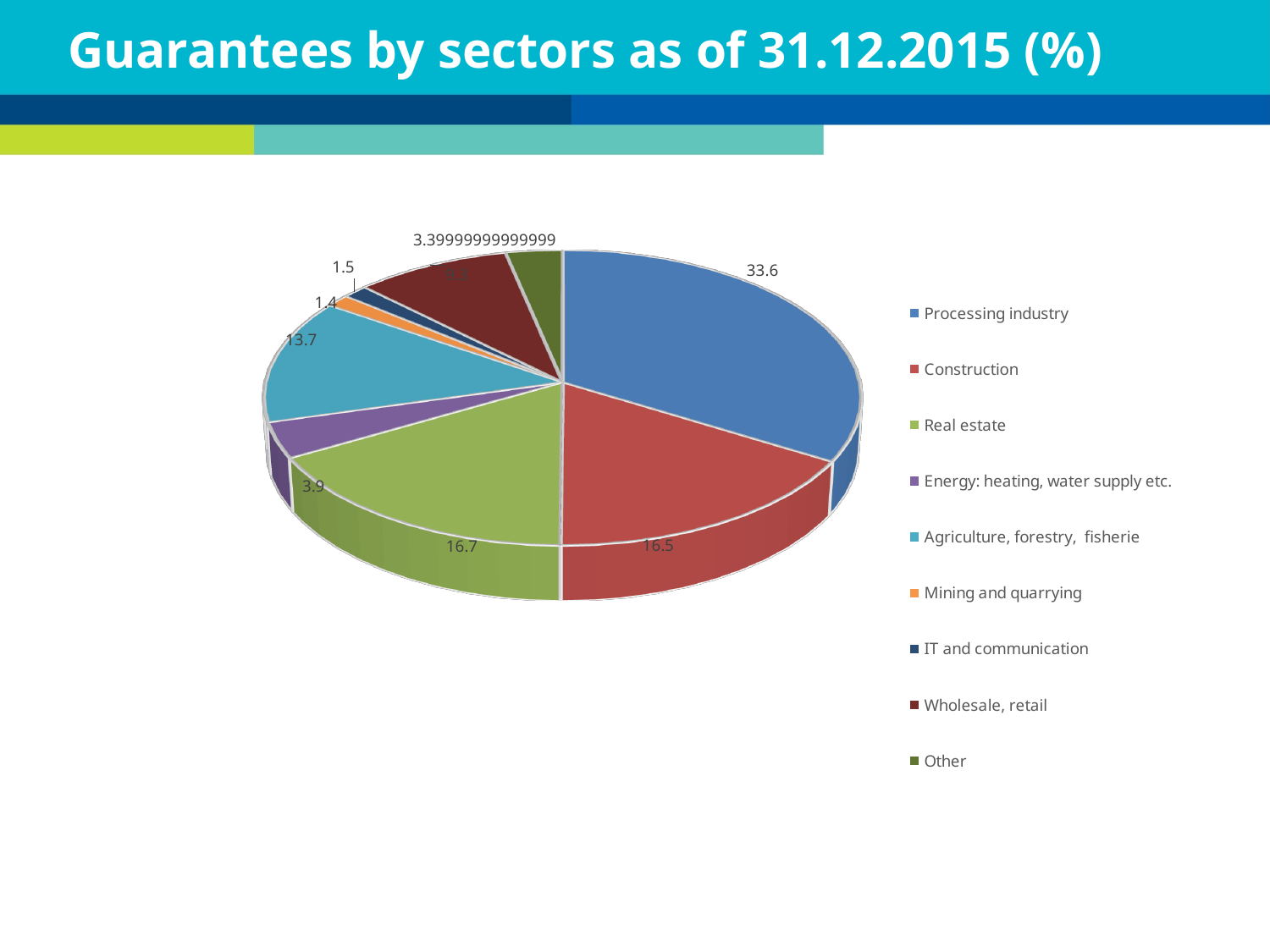
What is the value shown for Energy: heating, water supply etc.? 3.9 What percentage of guarantees is attributed to the Processing industry? 33.6 Which sector has the largest share of guarantees? Processing industry What type of chart is shown on the slide? Pie chart What is the value shown for Agriculture, forestry, fisherie? 13.7 Which sector has the smallest share of guarantees? Mining and quarrying Which is larger, the value for Real estate or the value for Construction? Real estate What is the value shown for Real estate? 16.7 How many sectors are listed in the legend? 9 What is the difference between the Processing industry value and the Construction value? 17.1 What is the value shown for Mining and quarrying? 1.4 What is the value shown for Construction? 16.5